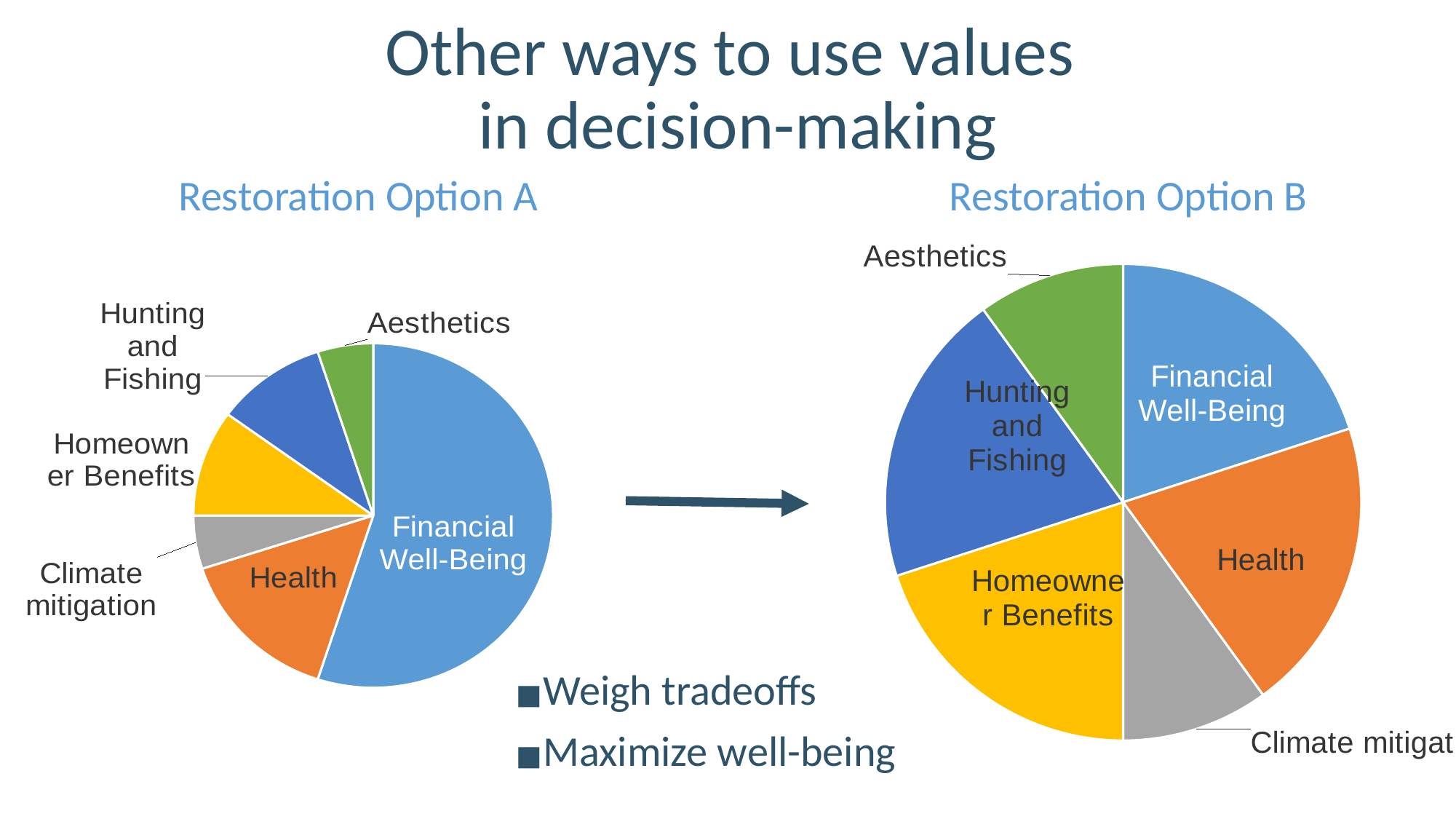
How many categories (slices) does the Restoration Option A pie chart have? 6 In the Restoration Option A chart, which slice is larger: Health or Homeowner Benefits? Health In the Restoration Option B chart, which slice is larger: Financial Well-Being or Aesthetics? Financial Well-Being How many categories (slices) does the Restoration Option B pie chart have? 6 In the Restoration Option B chart, which slice is larger: Hunting and Fishing or Aesthetics? Hunting and Fishing What is the title of the pie chart on the left side of the slide? Restoration Option A What kind of chart is used for Restoration Option A? Pie chart In the Restoration Option A chart, which category has the largest slice? Financial Well-Being What colour is the Health slice in the Restoration Option B chart? Orange